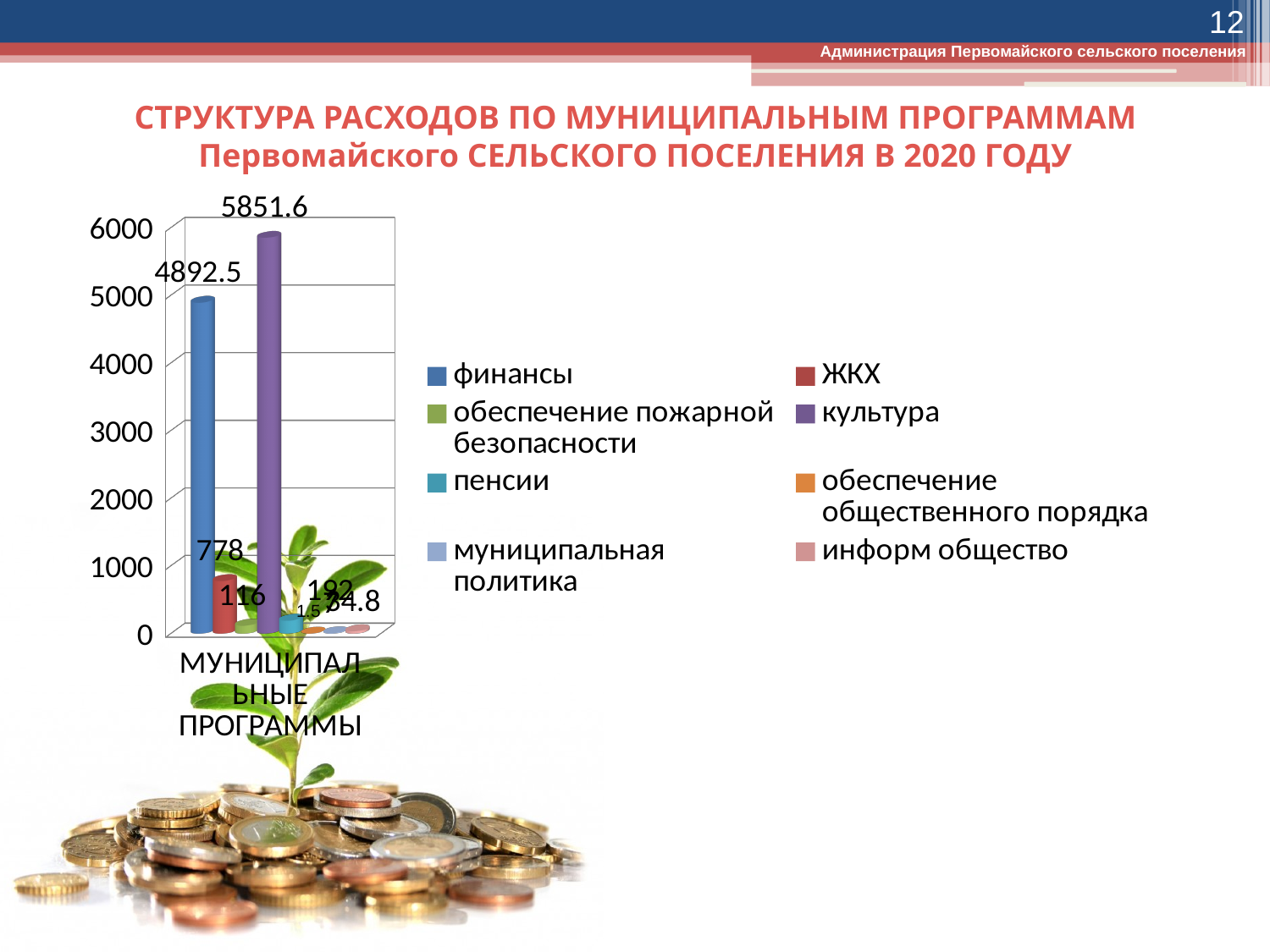
What is the value for обеспечение пожарной безопасности? 116 What is the value for финансы? 4892.5 What is the difference between the values for ЖКХ and обеспечение пожарной безопасности? 662 What kind of chart is shown on the slide? bar chart What is the value for культура? 5851.6 How many series does the legend list? 8 What is the value for ЖКХ? 778 Which is larger, the value for финансы or the value for культура? культура Which series has the highest value? культура Is the value for ЖКХ greater or less than 1000? less What is the difference between the values for культура and финансы? 959.1 How many categories are shown on the x axis? 1